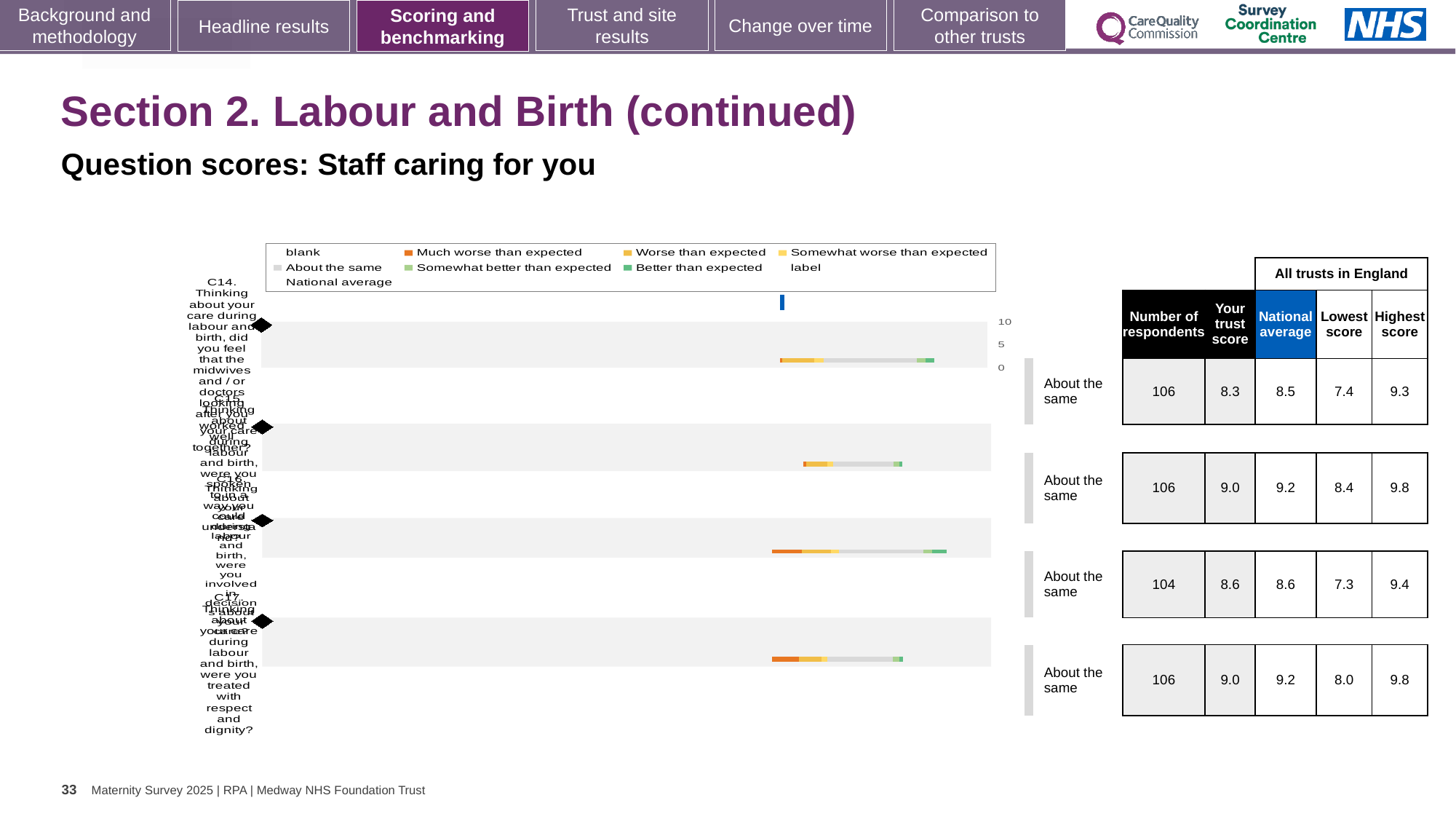
In the table to the right of the chart, what is the 'Lowest score' for the fourth row (C17)? 8.0 In the table to the right of the chart, which row has the lowest 'Your trust score'? C14 (first row) In the table to the right of the chart, what is the 'Number of respondents' for the third row (C16)? 104 How many question rows (bars) are plotted in the chart? 4 What colour does the legend use for 'Better than expected'? green In the table to the right of the chart, what is the difference between the 'Highest score' and 'Lowest score' for the first row (C14)? 1.9 In the table to the right of the chart, is the 'Your trust score' for the second row (C15) larger or smaller than its 'National average'? smaller What kind of chart is shown on the slide? bar chart In the table to the right of the chart, what is the 'Your trust score' for the first row (C14)? 8.3 In the table to the right of the chart, what is the 'National average' for the first row (C14)? 8.5 What colour does the legend use for 'Much worse than expected'? orange How many entries does the chart's legend list? 9